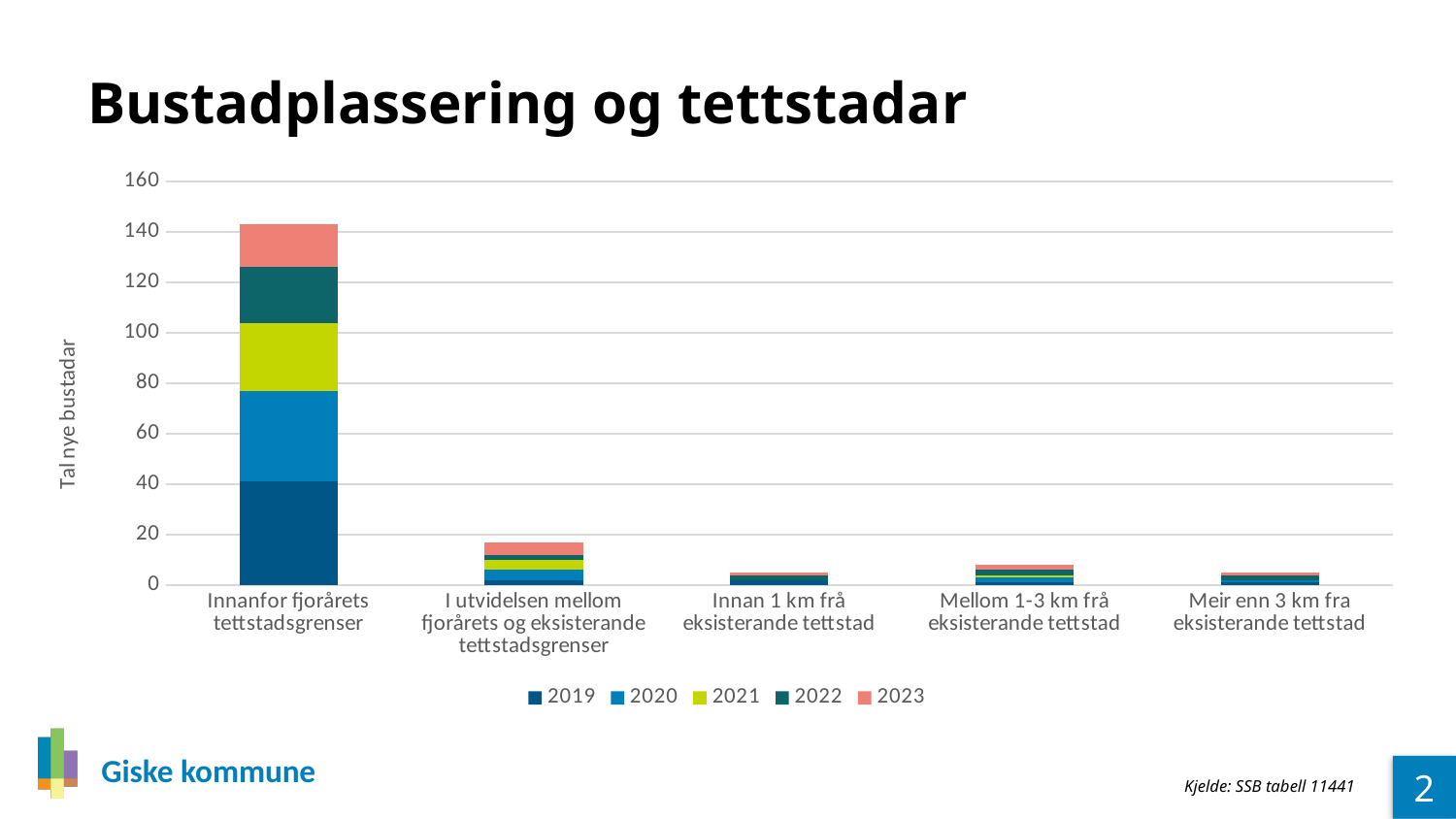
What is the label of the y axis? Tal nye bustadar Which has a larger total: 'I utvidelsen mellom fjorårets og eksisterande tettstadsgrenser' or 'Mellom 1-3 km frå eksisterande tettstad'? I utvidelsen mellom fjorårets og eksisterande tettstadsgrenser Is the total for 'I utvidelsen mellom fjorårets og eksisterande tettstadsgrenser' greater or less than 20? less How many categories are shown on the x axis of the chart? 5 Is the total for 'Innanfor fjorårets tettstadsgrenser' greater or less than 120? greater What kind of chart is shown on the slide? stacked bar chart What is the title of the chart on the slide? Bustadplassering og tettstadar Which category has the highest total number of new dwellings? Innanfor fjorårets tettstadsgrenser Which has a larger total: 'Innanfor fjorårets tettstadsgrenser' or 'Innan 1 km frå eksisterande tettstad'? Innanfor fjorårets tettstadsgrenser Is the 2019 value for 'Innanfor fjorårets tettstadsgrenser' greater or less than 20? greater How many series does the legend list? 5